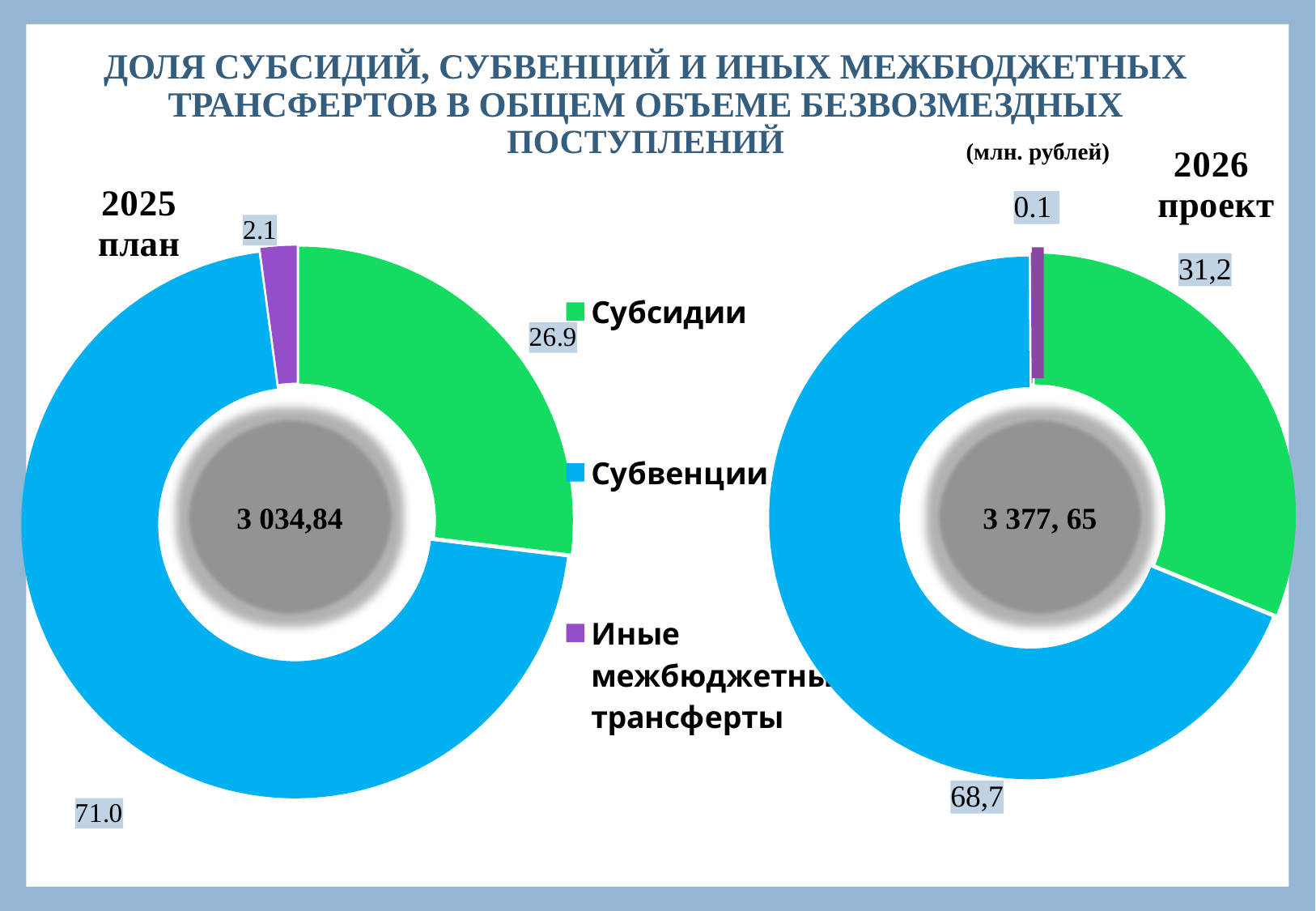
In the 2026 проект chart on the right, which is larger: Субсидии or Субвенции? Субвенции What total value is shown in the centre of the 2026 проект chart on the right? 3 377, 65 In the 2026 проект chart on the right, what is the value for Субсидии? 31,2 In the 2025 план chart on the left, which category has the largest share? Субвенции In the 2025 план chart on the left, what is the value for Субсидии? 26.9 In the 2025 план chart on the left, what is the value for Иные межбюджетные трансферты? 2.1 In the 2026 проект chart on the right, what is the value for Субвенции? 68,7 What kind of chart is used for the 2025 план chart on the left? doughnut chart In the 2026 проект chart on the right, what is the value for Иные межбюджетные трансферты? 0.1 In the 2025 план chart on the left, what is the value for Субвенции? 71.0 In the 2026 проект chart on the right, which category has the smallest share? Иные межбюджетные трансферты How many categories does the legend list for the charts? 3